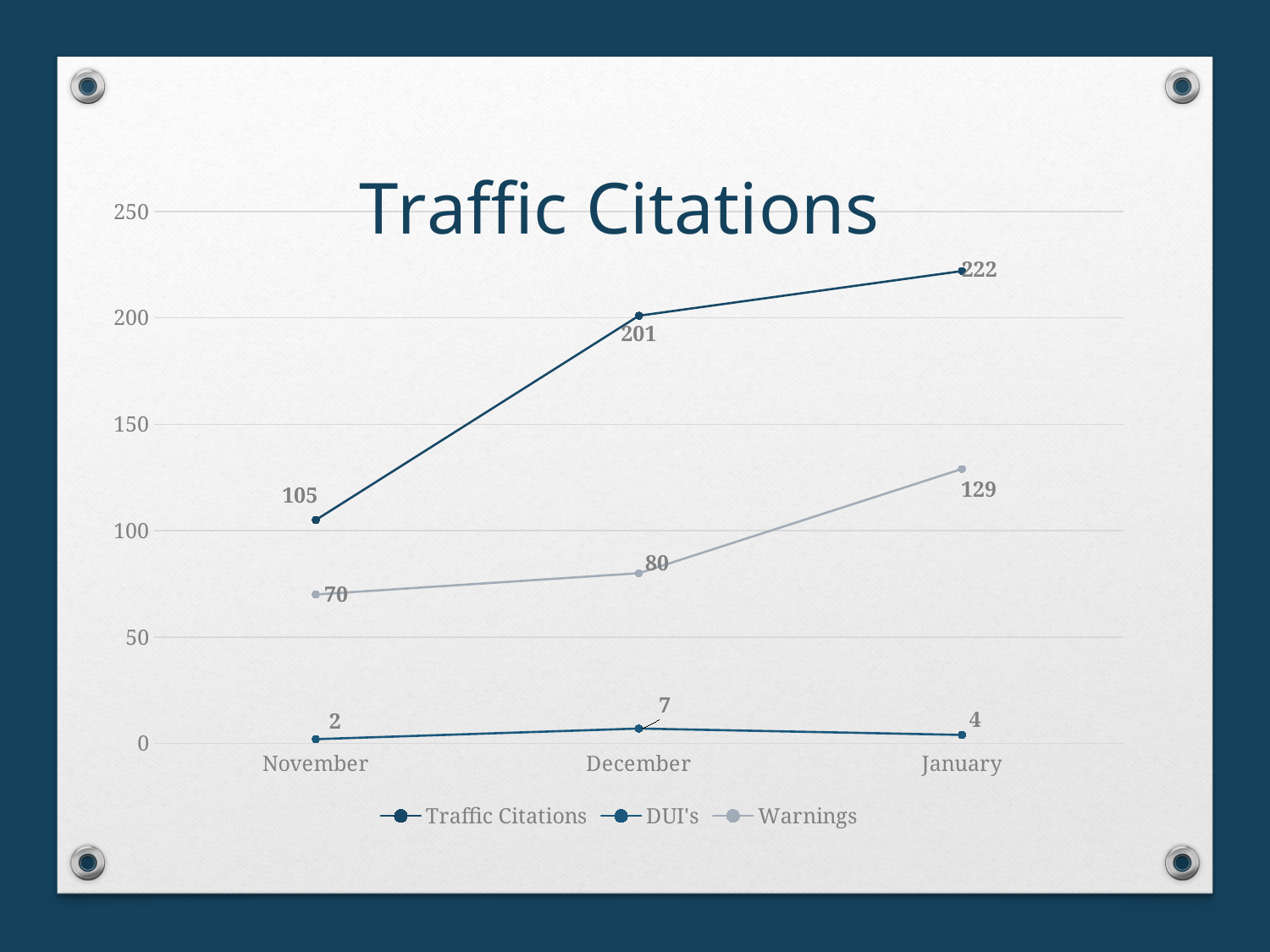
What is the value for Traffic Citations in December? 201 How many series does the legend list? 3 Is the value for Warnings in January greater or less than 100? greater Which is larger: Warnings in December or DUI's in December? Warnings in December What is the value for Warnings in January? 129 Do the Traffic Citations values rise or fall from November to January? Rise In which month is the Traffic Citations value highest? January What is the difference between Traffic Citations in January and in November? 117 How many months are shown on the x axis? 3 What is the value for DUI's in November? 2 In which month is the Warnings value lowest? November What kind of chart is shown on the slide? Line chart